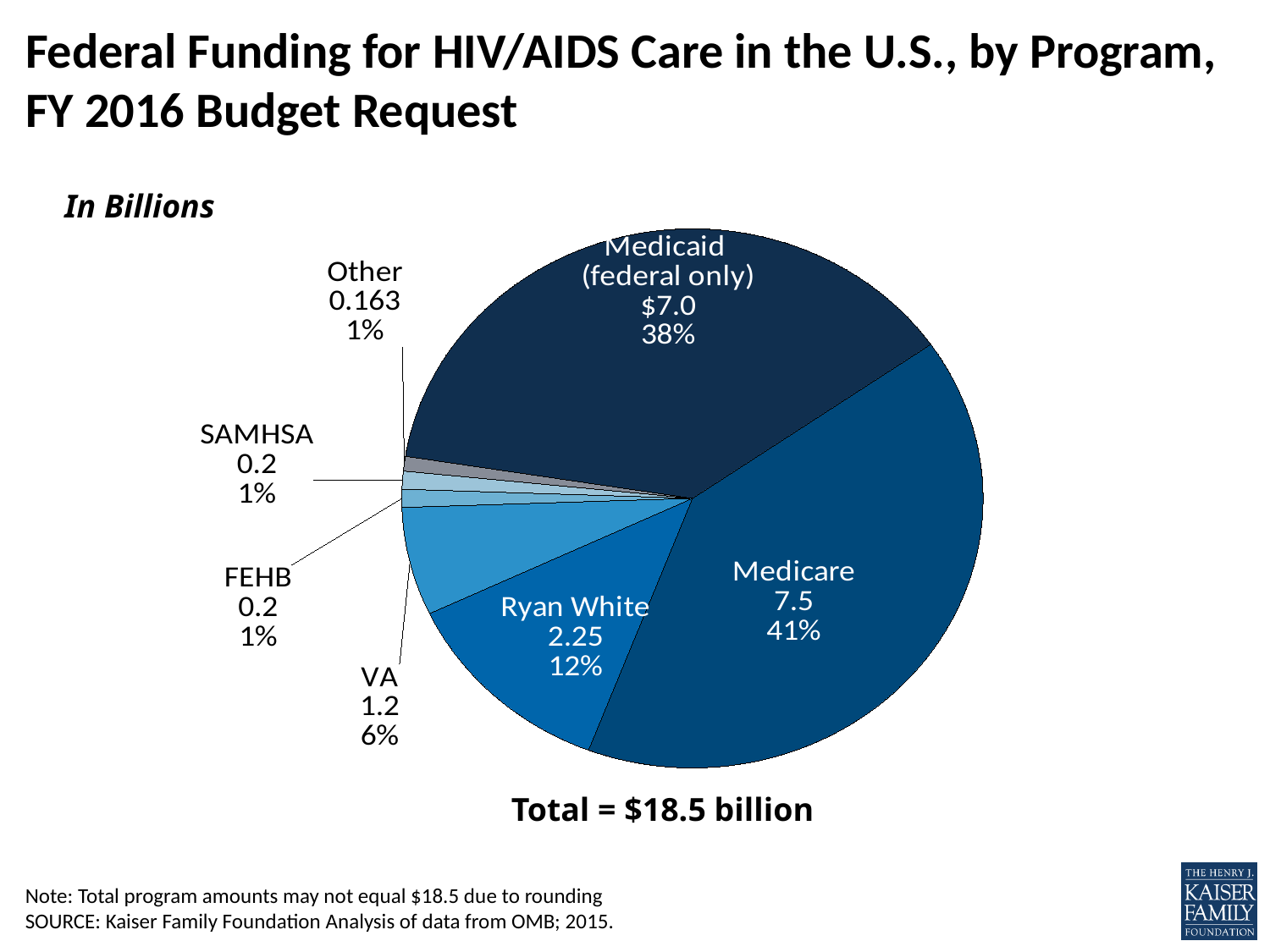
What is the value for Other? 0.163 How many slices does the pie chart have? 7 Which program has the largest share of the pie? Medicare Which program has the smallest share of the pie? Other What is the value for Medicare? 7.5 What share of the pie does Ryan White represent? 12% What is the value for Ryan White? 2.25 What total is stated below the pie chart? Total = $18.5 billion What is the value for Medicaid (federal only)? $7.0 What is the value for VA? 1.2 What type of chart is shown on the slide? pie chart What share of the pie does Medicaid (federal only) represent? 38%